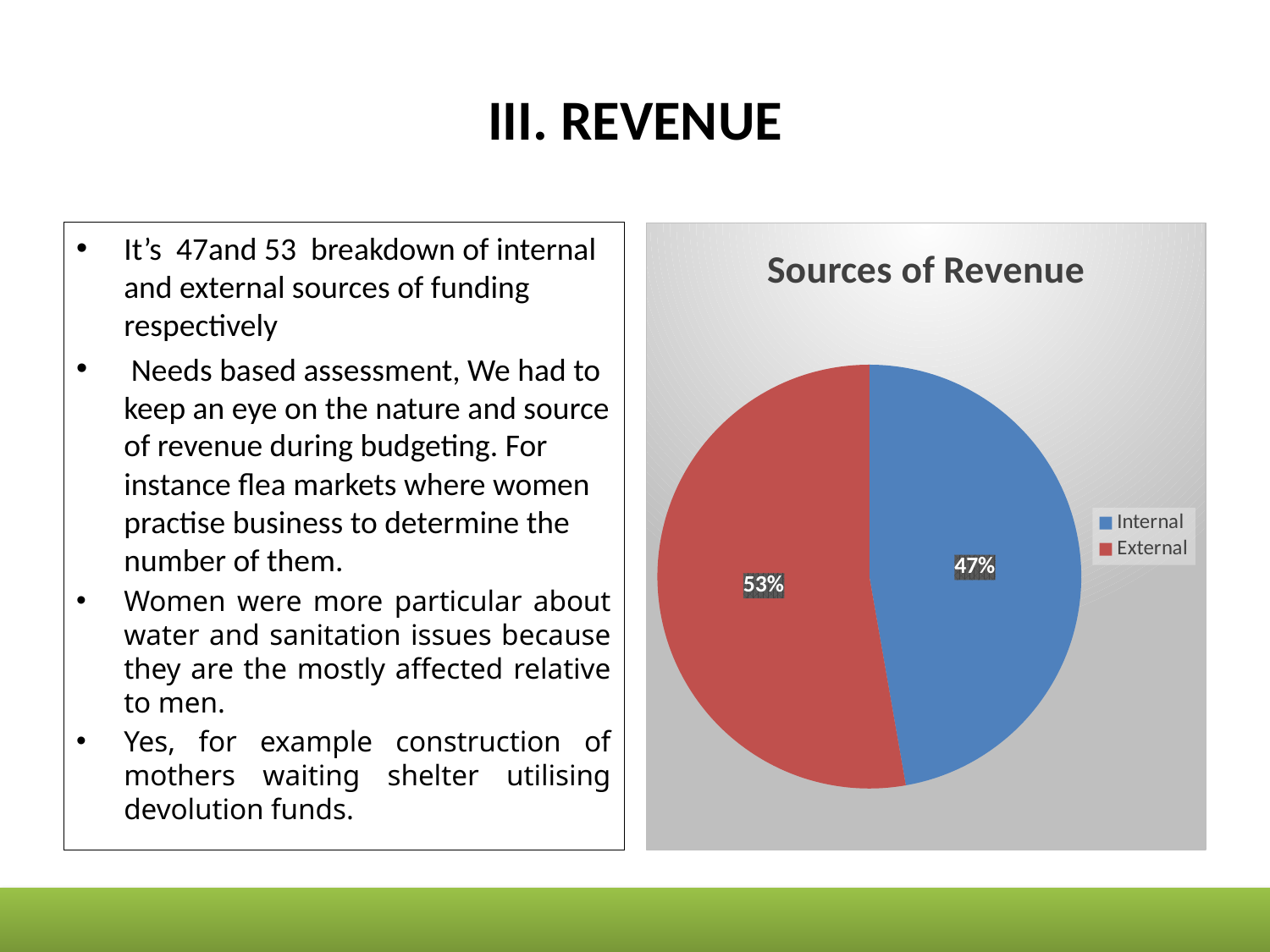
What share of revenue comes from External sources? 53% How many entries does the legend list? 2 What is the difference in percentage points between the External and Internal shares? 6 What kind of chart is shown on the slide? pie chart What share of revenue comes from Internal sources? 47% What is the title of the pie chart? Sources of Revenue Which source of revenue has the smallest share? Internal How many slices does the pie chart have? 2 Which is larger, the Internal share or the External share? External What colour is the External slice in the pie chart? red Which source of revenue has the largest share? External